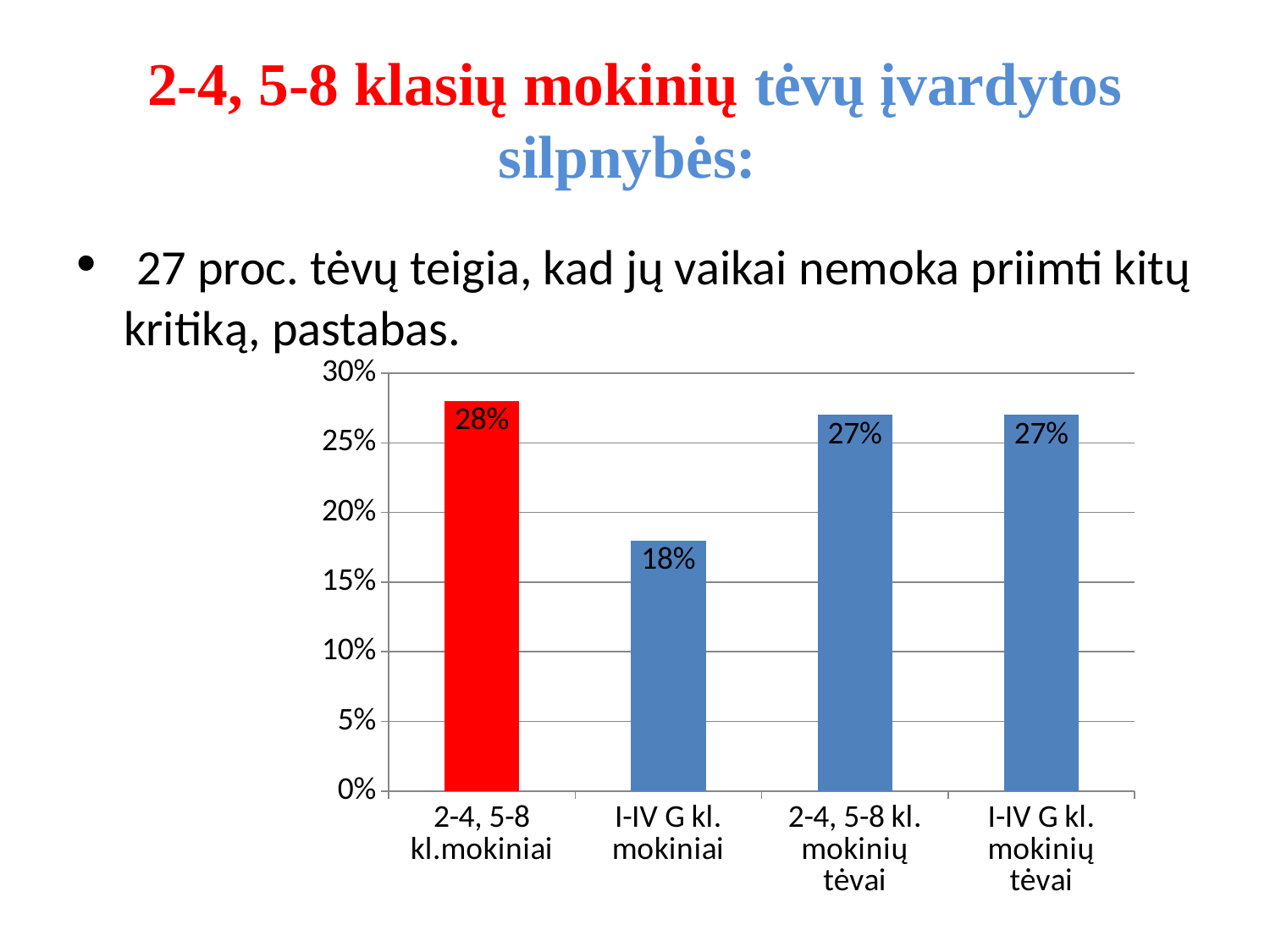
What is the value for "I-IV G kl. mokiniai"? 18% What is the difference between the values for "2-4, 5-8 kl.mokiniai" and "I-IV G kl. mokiniai"? 10% What is the value for "2-4, 5-8 kl. mokinių tėvai"? 27% Which is larger, the value for "I-IV G kl. mokiniai" or the value for "I-IV G kl. mokinių tėvai"? I-IV G kl. mokinių tėvai Which category has the highest value? 2-4, 5-8 kl.mokiniai Which category has the lowest value? I-IV G kl. mokiniai What kind of chart is shown on the slide? bar chart Which bar is coloured red? 2-4, 5-8 kl.mokiniai What is the value for "I-IV G kl. mokinių tėvai"? 27% How many categories are shown on the chart? 4 What is the value for "2-4, 5-8 kl.mokiniai"? 28% Is the value for "I-IV G kl. mokiniai" greater or less than 20%? less